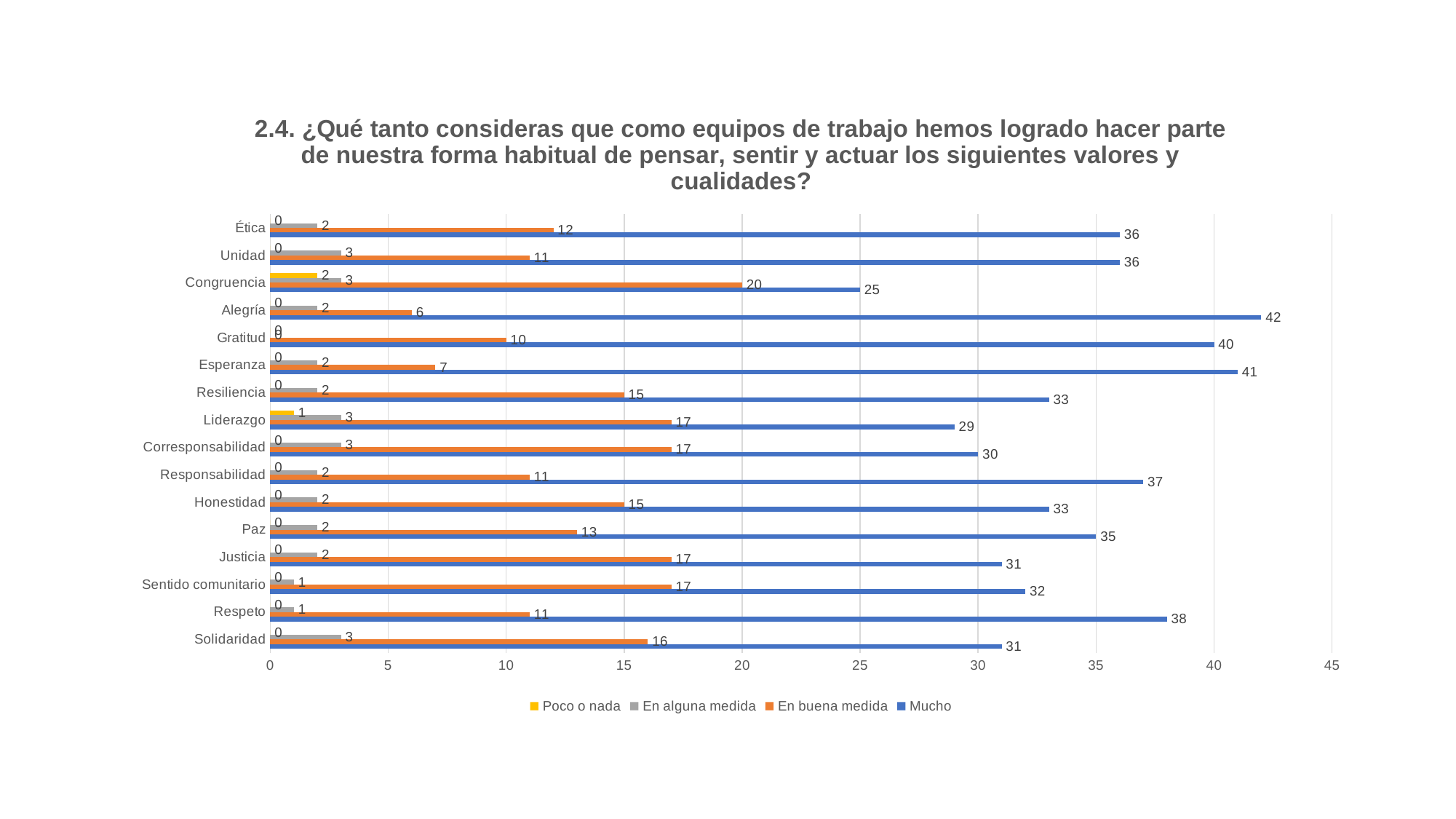
Which category has the lowest value in the 'Mucho' series? Congruencia What is the difference between the 'Mucho' values for Respeto and Liderazgo? 9 How many categories are shown on the chart? 16 What is the value of the 'En buena medida' series for Congruencia? 20 Which is larger: the 'Mucho' value for Responsabilidad or for Paz? Responsabilidad What is the value of the 'En alguna medida' series for Solidaridad? 3 What is the value of the 'Mucho' series for Alegría? 42 What kind of chart is shown on the slide? Bar chart How many series does the legend list? 4 Which category has the lowest value in the 'En buena medida' series? Alegría Which category has the highest value in the 'Mucho' series? Alegría What is the total of the four series values for Gratitud? 50